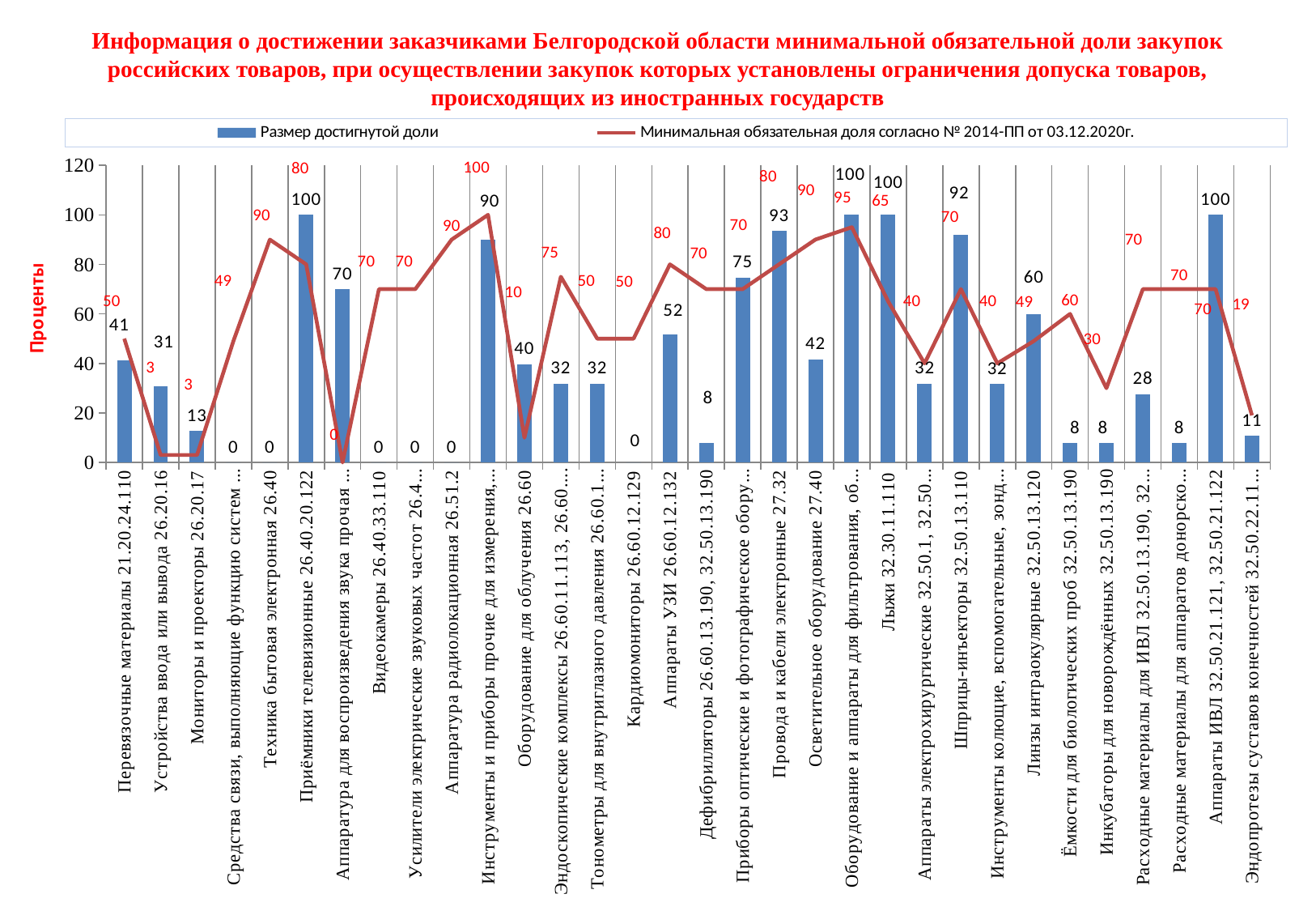
What is the label of the vertical axis? Проценты What is the achieved share for Мониторы и проекторы 26.20.17? 13 How many series does the legend list? 2 What is the minimum mandatory share (red line) for Аппараты УЗИ 26.60.12.132? 80 What type of chart is used to show the achieved share (Размер достигнутой доли)? bar chart Which has a higher achieved share: Линзы интраокулярные 32.50.13.120 or Расходные материалы для ИВЛ 32.50.13.190, 32...? Линзы интраокулярные 32.50.13.120 Which is larger for Осветительное оборудование 27.40: the achieved share or the minimum mandatory share? the minimum mandatory share What is the achieved share for Провода и кабели электронные 27.32? 93 What is the minimum mandatory share for Эндопротезы суставов конечностей 32.50.22.11...? 19 What is the achieved share (Размер достигнутой доли) for Лыжи 32.30.11.110? 100 By how much does the achieved share for Шприцы-инъекторы 32.50.13.110 exceed its minimum mandatory share? 22 What is the difference between the minimum mandatory share and the achieved share for Дефибрилляторы 26.60.13.190, 32.50.13.190? 62